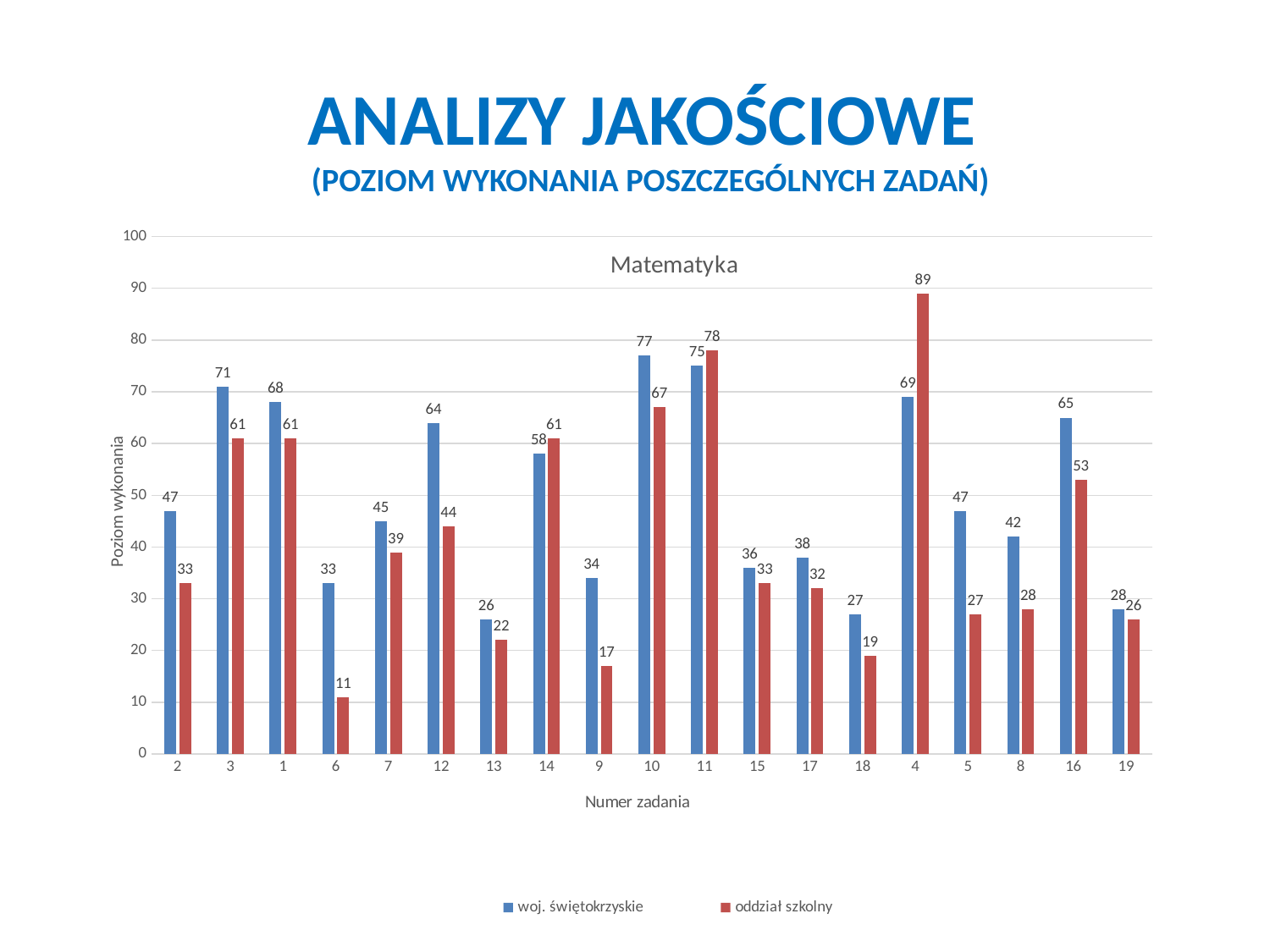
Which task number has the highest value for oddział szkolny? 4 How many series does the legend list? 2 For task number 14, which series has the larger value: woj. świętokrzyskie or oddział szkolny? oddział szkolny Which task number has the lowest value for woj. świętokrzyskie? 13 For task number 5, which series has the larger value: woj. świętokrzyskie or oddział szkolny? woj. świętokrzyskie What is the value for oddział szkolny for task number 4? 89 What kind of chart is shown on the slide? bar chart What is the value for woj. świętokrzyskie for task number 10? 77 What is the title of the chart? Matematyka What is the difference between woj. świętokrzyskie and oddział szkolny for task number 12? 20 What is the value for oddział szkolny for task number 6? 11 How many task numbers are shown on the x axis? 19